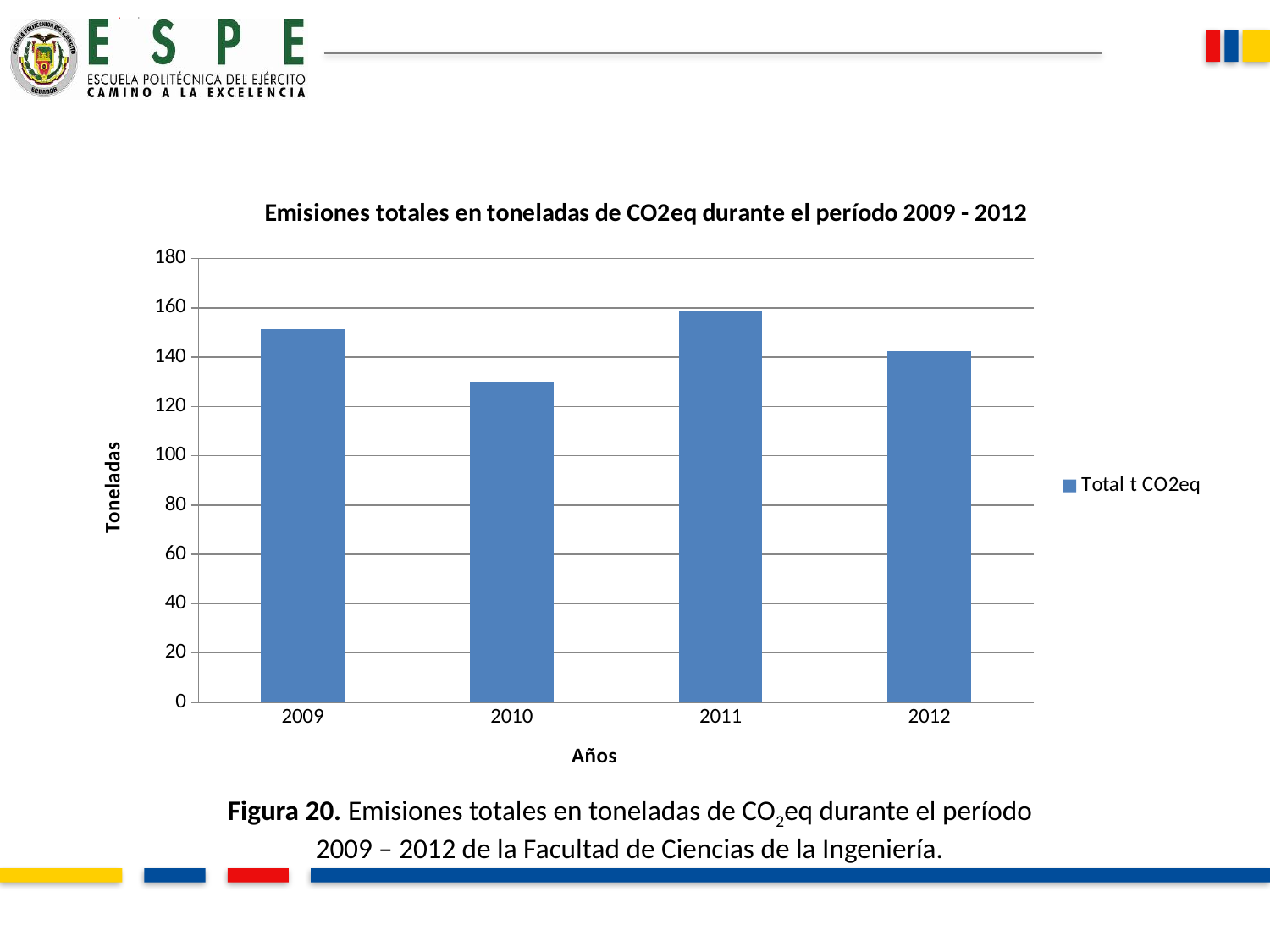
How many years are shown on the x axis of the chart? 4 Which year has higher emissions, 2009 or 2010? 2009 What kind of chart is shown on the slide? bar chart How many series does the legend list? 1 Do the emissions rise or fall from 2009 to 2010? fall Which year has higher emissions, 2011 or 2012? 2011 Is the value for 2010 greater or less than 140? less Is the value for 2012 greater or less than 160? less What is the legend entry for the series in the chart? Total t CO2eq Which year has the lowest total emissions? 2010 Is the value for 2009 greater or less than 140? greater Which year has the highest total emissions? 2011